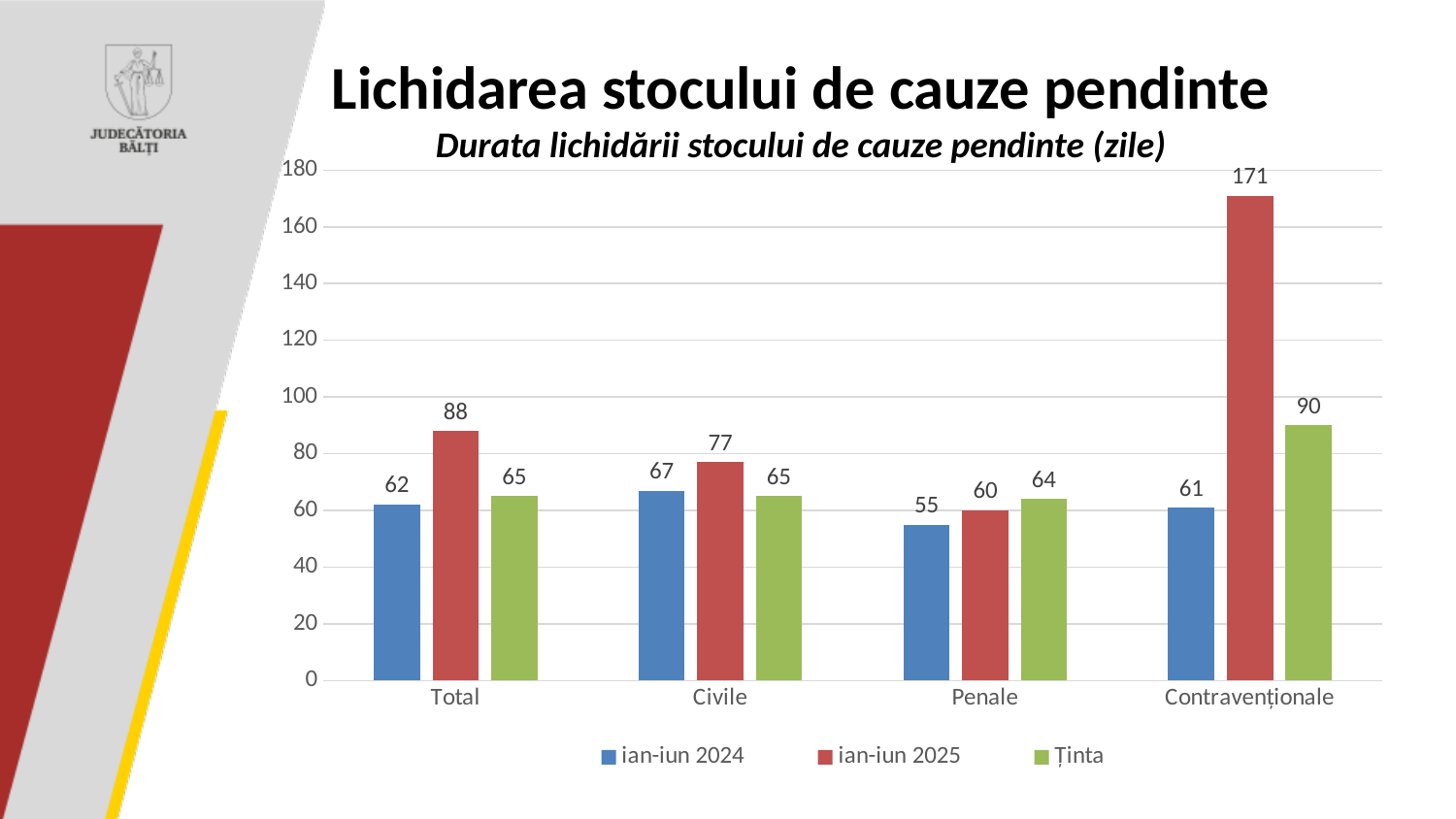
Which category has the lowest ian-iun 2024 value? Penale Which category has the highest ian-iun 2025 value? Contravenționale Is the ian-iun 2025 value for Contravenționale greater or less than 160? greater How many series does the legend list? 3 What is the value for Contravenționale in the ian-iun 2025 series? 171 How many categories are shown on the x axis? 4 What is the ian-iun 2024 value for Civile? 67 What is the difference between the ian-iun 2025 and ian-iun 2024 values for Total? 26 What kind of chart is shown on the slide? bar chart What is the Ținta value for Penale? 64 What is the subtitle of the chart? Durata lichidării stocului de cauze pendinte (zile) Which is larger for Civile: the ian-iun 2025 value or the Ținta value? ian-iun 2025